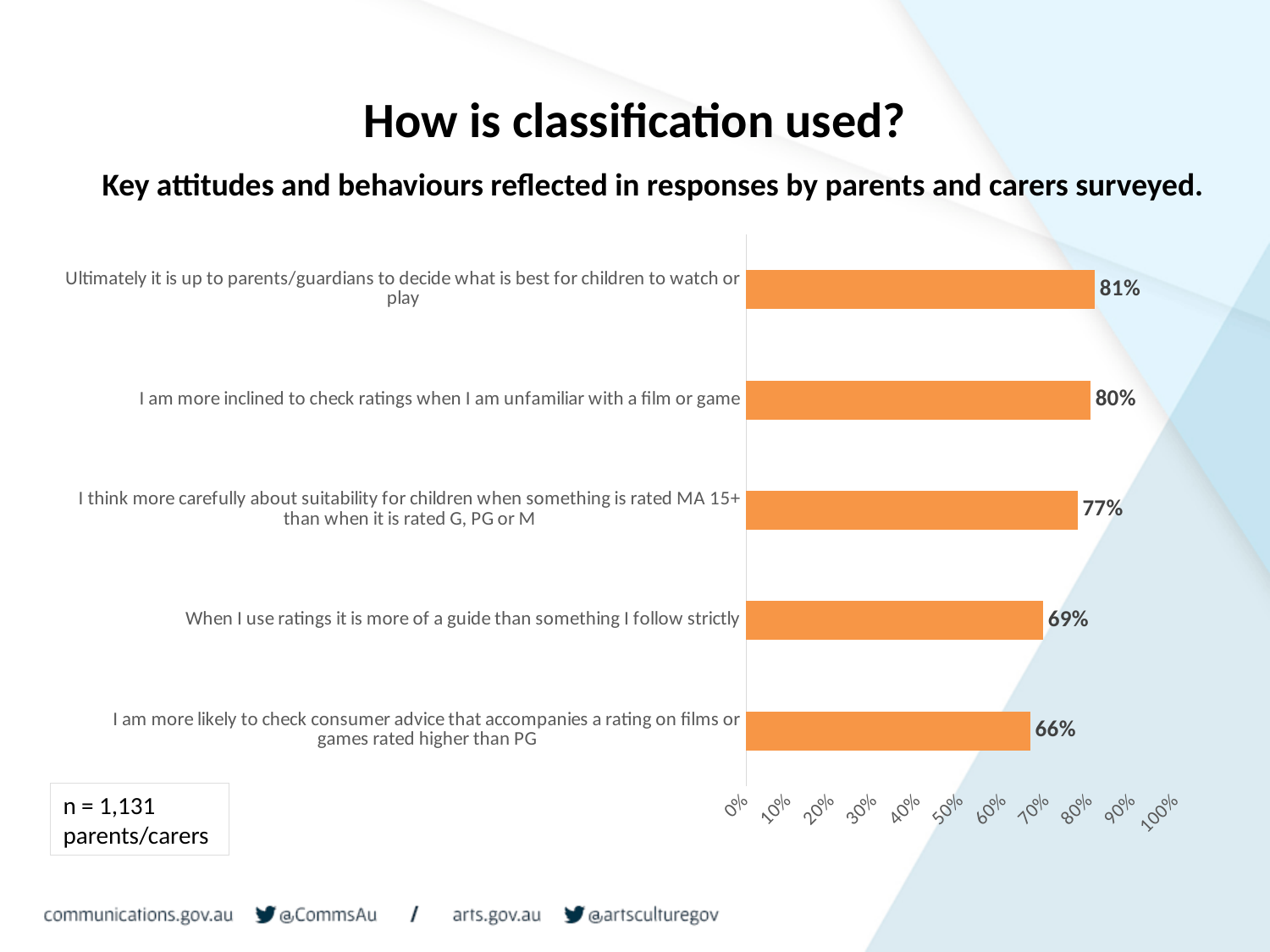
Which statement has the highest percentage of agreement? Ultimately it is up to parents/guardians to decide what is best for children to watch or play What type of chart is shown on the slide? Bar chart How many statements (bars) are shown in the chart? 5 What is the difference between the value for thinking more carefully about suitability when something is rated MA 15+ (77%) and the value for using ratings as a guide (69%)? 8% What percentage of parents/carers agreed that ultimately it is up to parents/guardians to decide what is best for children to watch or play? 81% What is the value for 'When I use ratings it is more of a guide than something I follow strictly'? 69% Which is larger: the value for checking ratings when unfamiliar with a film or game, or the value for checking consumer advice on films or games rated higher than PG? Checking ratings when unfamiliar with a film or game (80%) What percentage said they are more likely to check consumer advice that accompanies a rating on films or games rated higher than PG? 66% What is the sample size stated on the slide? n = 1,131 parents/carers What is the difference between the highest and lowest percentages shown? 15% What percentage of respondents said they are more inclined to check ratings when unfamiliar with a film or game? 80% Which statement has the lowest percentage? I am more likely to check consumer advice that accompanies a rating on films or games rated higher than PG